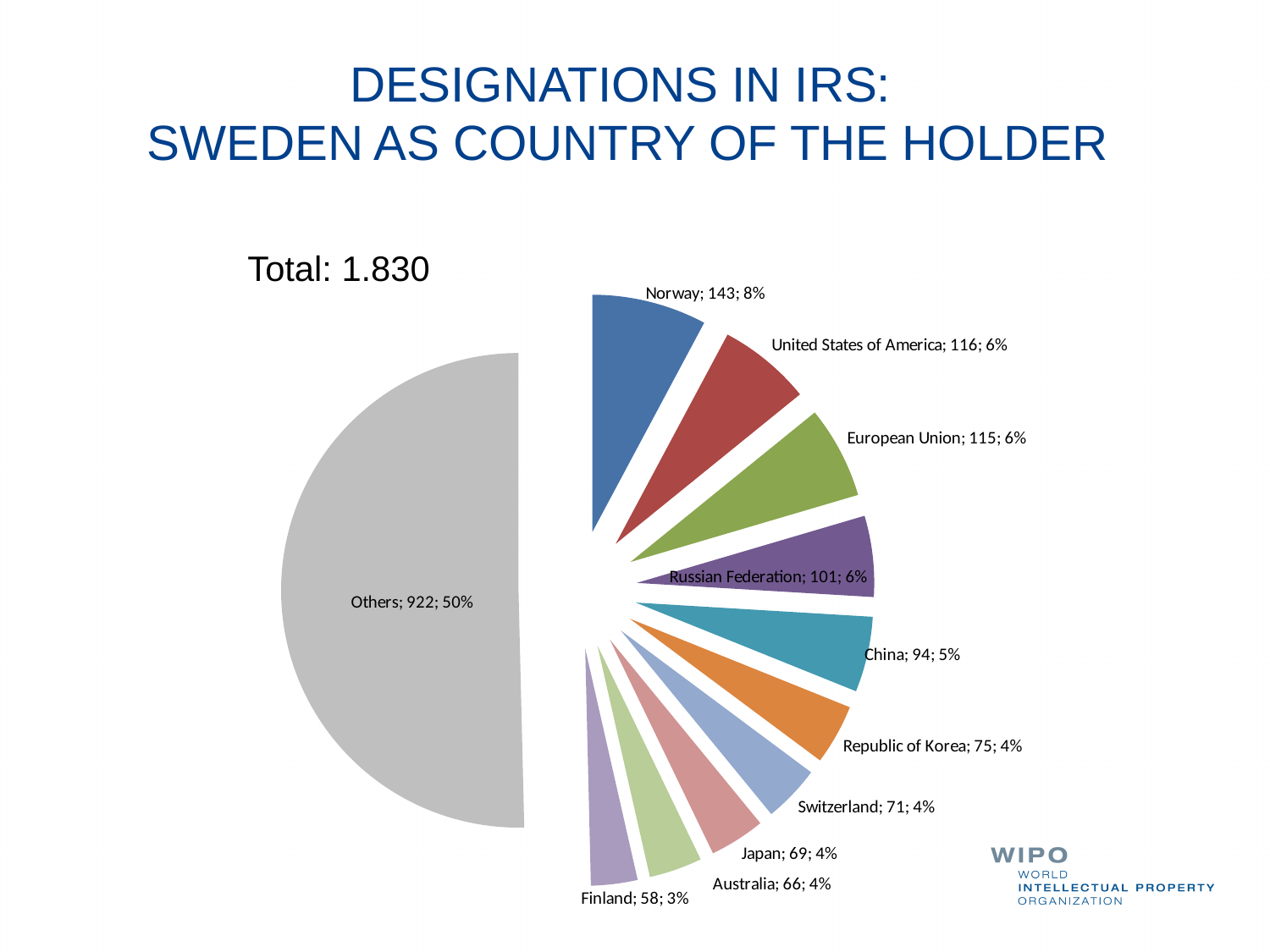
What percentage share does the Others slice represent? 50% What percentage share is shown for Finland? 3% How many slices does the pie chart have? 11 What is the difference between the values for the United States of America and the European Union? 1 What is the difference between the values for Switzerland and Japan? 2 Which is larger, the value for China or the value for the Republic of Korea? China Which category has the smallest slice? Finland Which named country (excluding Others) has the largest slice? Norway What is the value shown for the Russian Federation? 101 What total is stated on the slide? 1.830 How many designations are shown for Norway? 143 What kind of chart is shown on the slide? Pie chart